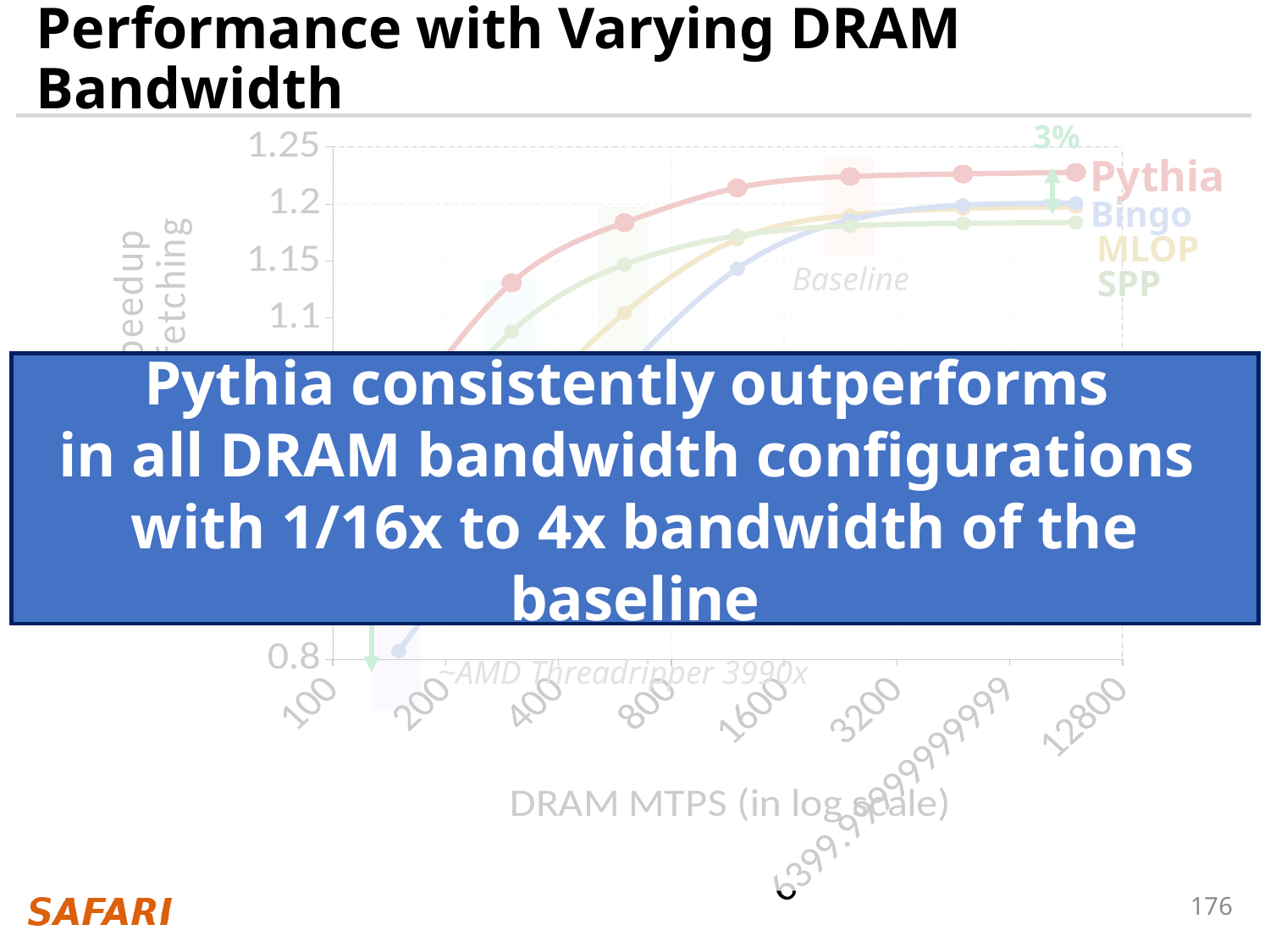
What kind of chart is shown on the slide? line chart Is the value for SPP at 12800 DRAM MTPS greater or less than 1.2? less What percentage is annotated next to the Pythia line at the right end of the chart? 3% What is the x-axis title of the chart? DRAM MTPS (in log scale) Which series has the lowest speedup at the right end of the chart (12800 DRAM MTPS)? SPP Is the value for Pythia at 400 DRAM MTPS greater or less than 1.1? greater Do the speedup values rise or fall as DRAM MTPS increases along the x axis? rise At 800 DRAM MTPS, which series has the higher speedup, Pythia or Bingo? Pythia Which series has the highest speedup at the right end of the chart (12800 DRAM MTPS)? Pythia Is the value for Pythia at 12800 DRAM MTPS greater or less than 1.2? greater How many tick labels are shown on the x axis? 8 How many series (prefetchers) are labelled on the chart? 4